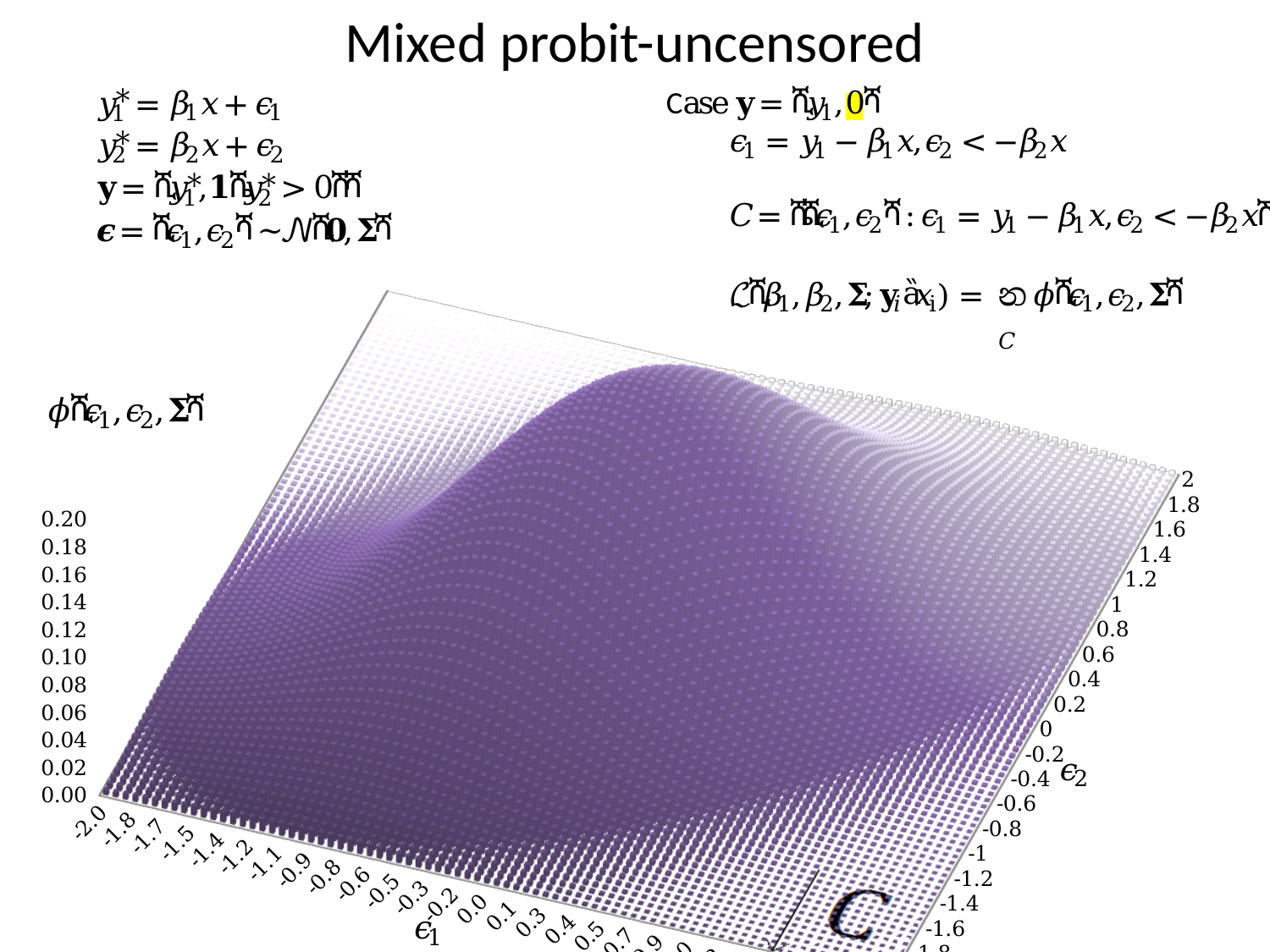
What is the spacing between consecutive tick labels on the vertical axis? 0.02 Moving along the ε1 axis from -2.0 toward positive values, does the surface height rise, fall, or rise then fall? rise then fall What function is the plotted surface labelled as? φ(ε1, ε2, Σ) What is the smallest tick value shown on the ε1 axis of the chart? -2.0 What is the largest tick value shown on the ε2 axis of the chart? 2 What kind of chart is shown on the slide? 3D surface chart What is the lowest tick value shown on the vertical axis of the chart? 0.00 What letter marks the region in the front-right corner of the chart? C What is the highest tick value shown on the vertical axis of the chart? 0.20